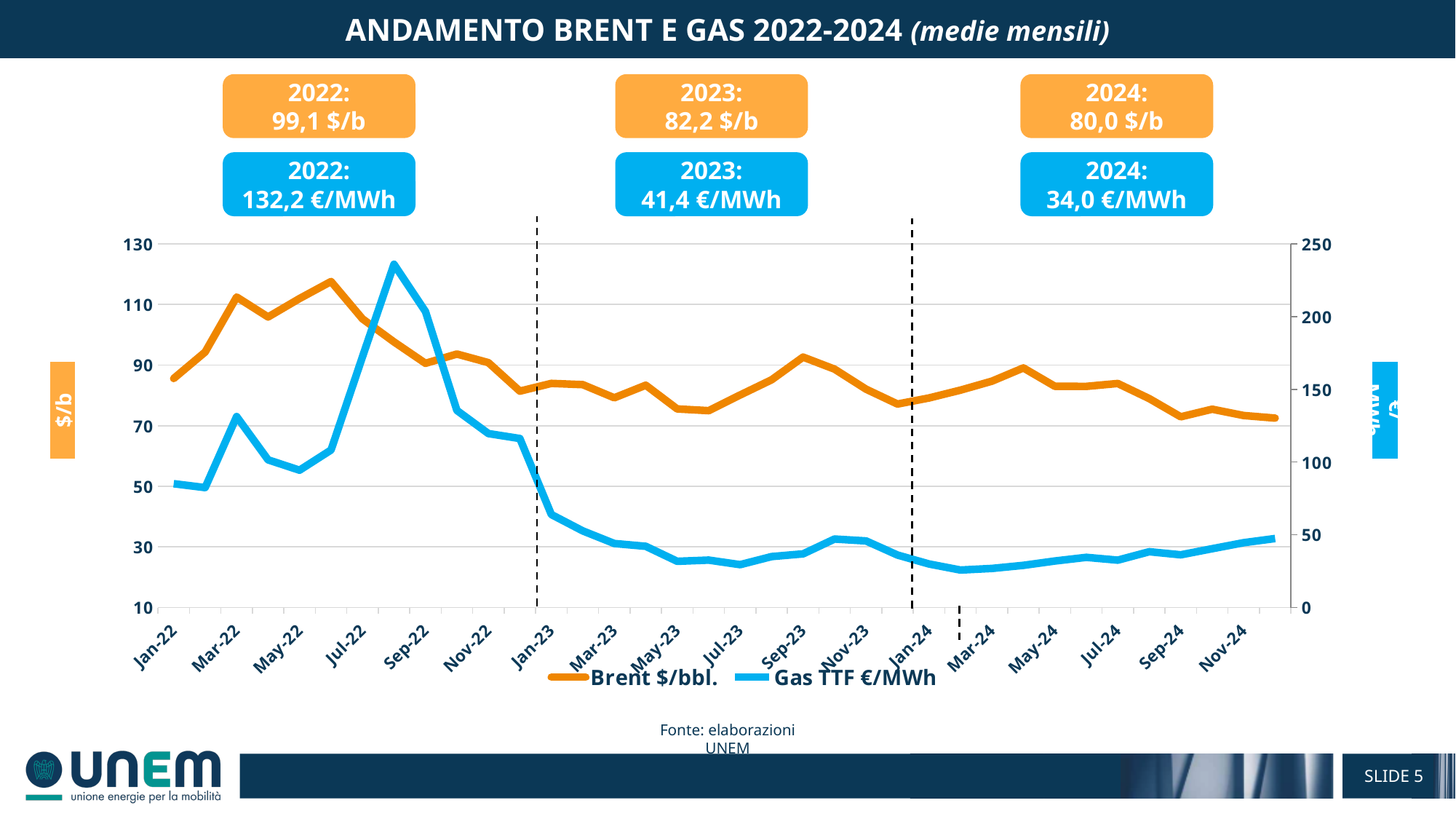
Is the 2023 annual average Brent price larger or smaller than the 2024 annual average Brent price? larger Which year has the highest annual average Brent price among the boxes shown? 2022 What kind of chart is shown on the slide? line chart What is the 2023 average Gas TTF price shown in the blue box? 41,4 €/MWh What is the 2024 average Gas TTF price shown in the blue box? 34,0 €/MWh What is the 2022 average Brent price shown in the orange box? 99,1 $/b Is the Gas TTF value for Aug-22 greater or less than 200 €/MWh? greater What is the difference between the 2022 and 2023 annual average Brent prices shown in the boxes? 16,9 $/b Does the Gas TTF line rise or fall from Aug-22 to Jan-23? fall Which year has the lowest annual average Gas TTF price among the boxes shown? 2024 How many series does the legend list? 2 Is the Brent value for Dec-24 greater or less than 90 $/bbl? less